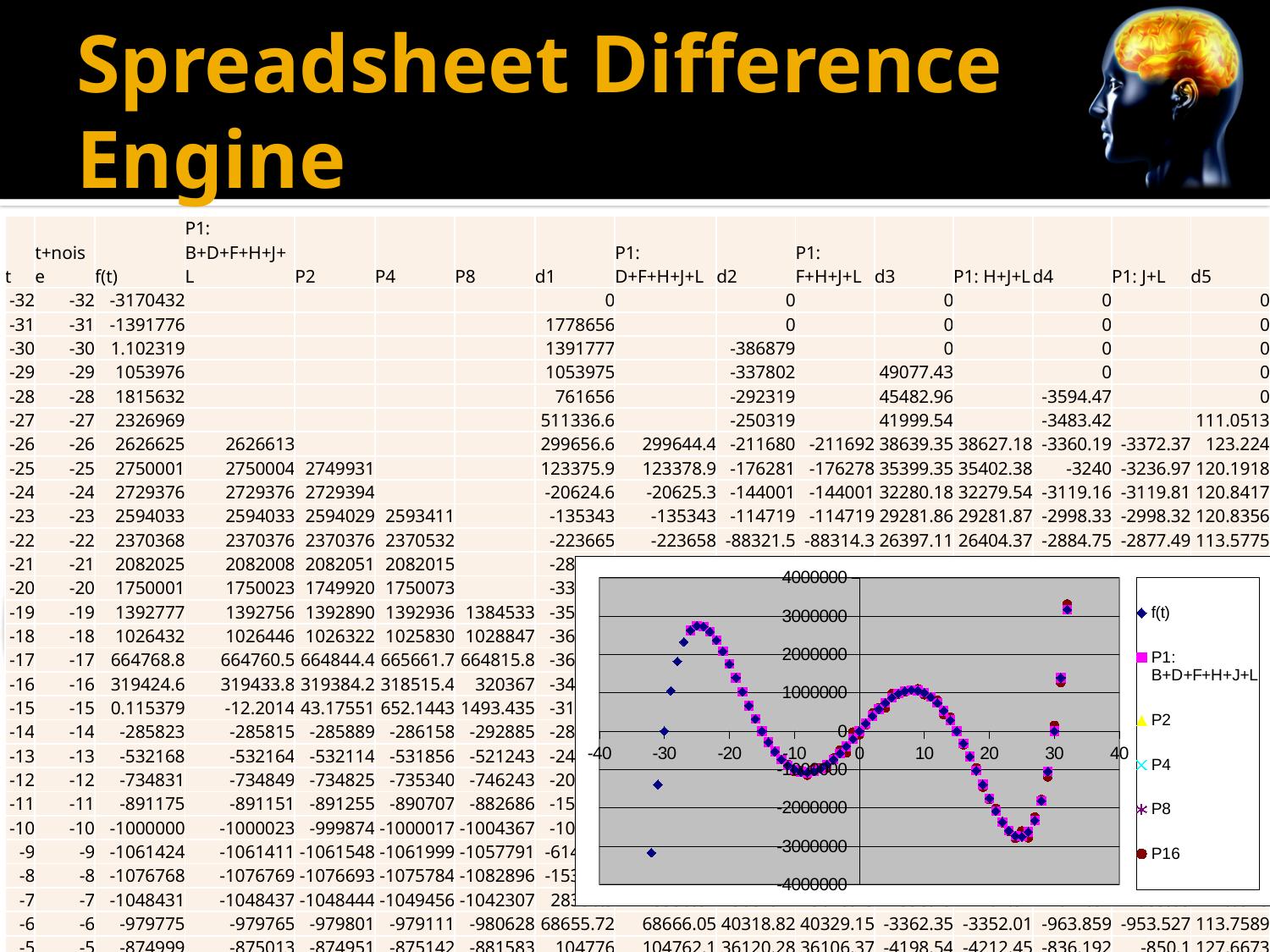
What is the highest value shown on the chart's y axis? 4000000 Is the value of f(t) at x = 8 greater or less than 2000000? less Do the plotted values rise or fall as x goes from -25 to -10? fall Is the value of f(t) at x = -10 greater or less than 0? less Which series is listed first in the chart's legend? f(t) How many series does the chart's legend list? 6 Is the value of f(t) at x = 25 greater or less than -2000000? less Which is larger, the value of f(t) at x = -25 or at x = 8? x = -25 What kind of chart is shown on the slide? scatter chart Do the plotted values rise or fall as x goes from -10 to 8? rise